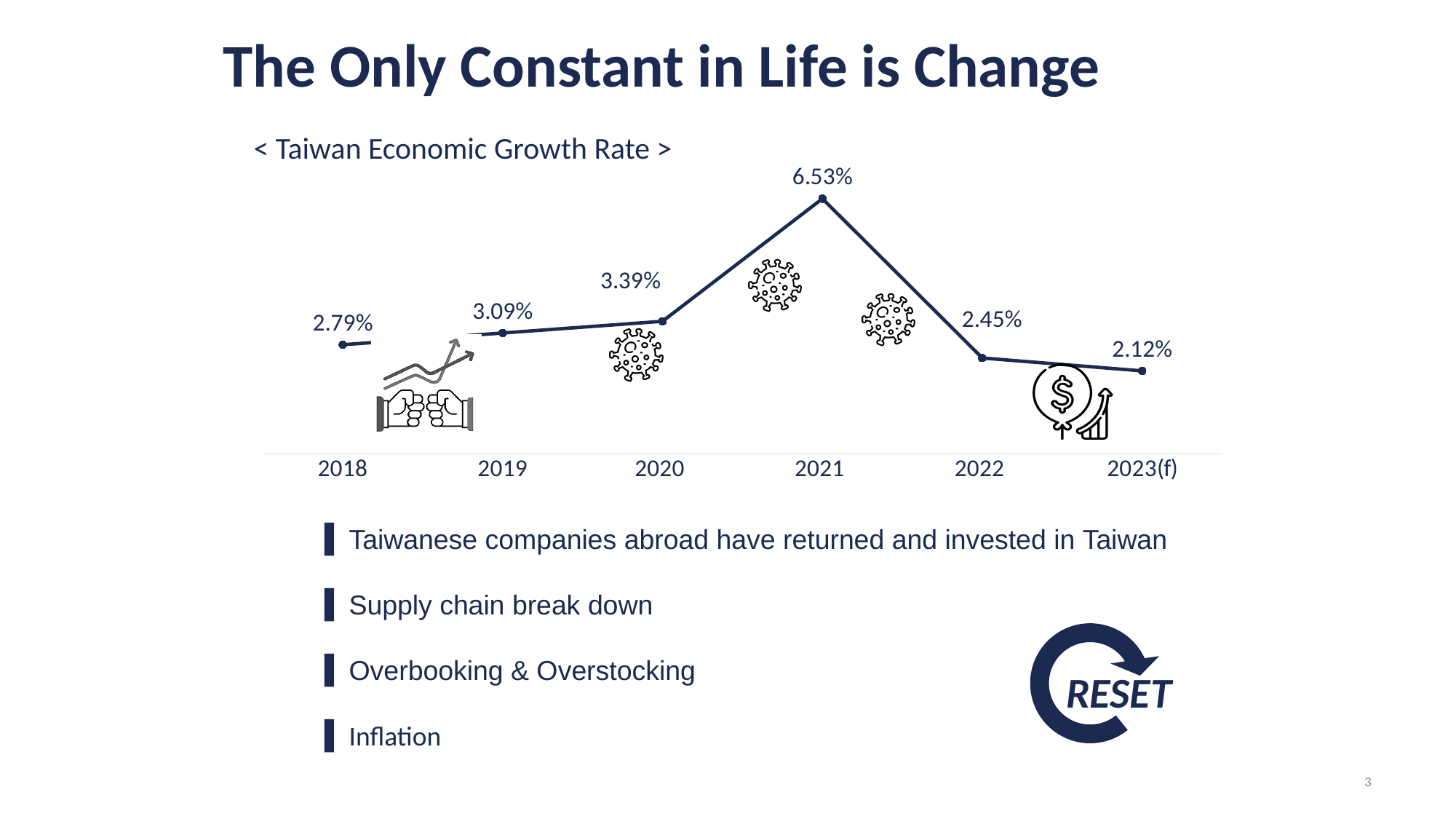
What is the difference between the growth rates for 2021 and 2022? 4.08% What is the Taiwan economic growth rate shown for 2021? 6.53% Which is larger, the growth rate for 2019 or for 2022? 2019 Which year has the lowest growth rate on the chart? 2023(f) What is the Taiwan economic growth rate shown for 2018? 2.79% What is the title of the chart? Taiwan Economic Growth Rate Which year has the highest growth rate on the chart? 2021 How many years are plotted on the chart? 6 What is the difference between the growth rates for 2020 and 2019? 0.30% What kind of chart is shown on the slide? Line chart What is the forecast growth rate shown for 2023(f)? 2.12% Does the growth rate rise or fall from 2021 to 2023(f)? Fall